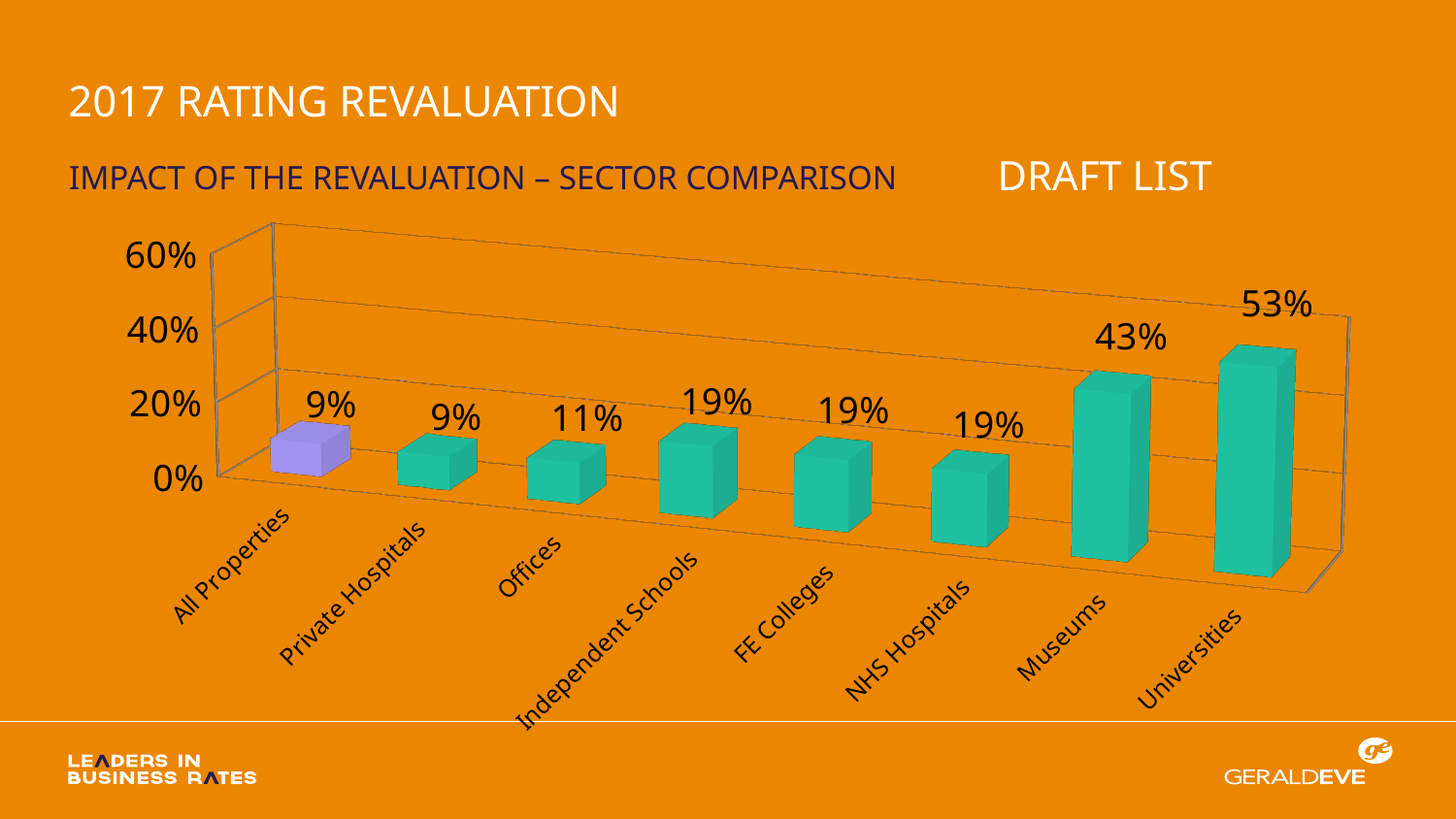
What is the value for All Properties? 9% Which is larger, the value for Museums or the value for NHS Hospitals? Museums What is the value for Universities? 53% What is the value for Offices? 11% What is the difference between the values for Universities and Museums? 10% What is the value for Museums? 43% What kind of chart is shown on the slide? Bar chart Which category has the highest value? Universities What is the difference between the values for Independent Schools and Offices? 8% How many categories are shown on the chart? 8 Which bar is coloured differently from the others? All Properties Is the value for Universities greater or less than 40%? greater